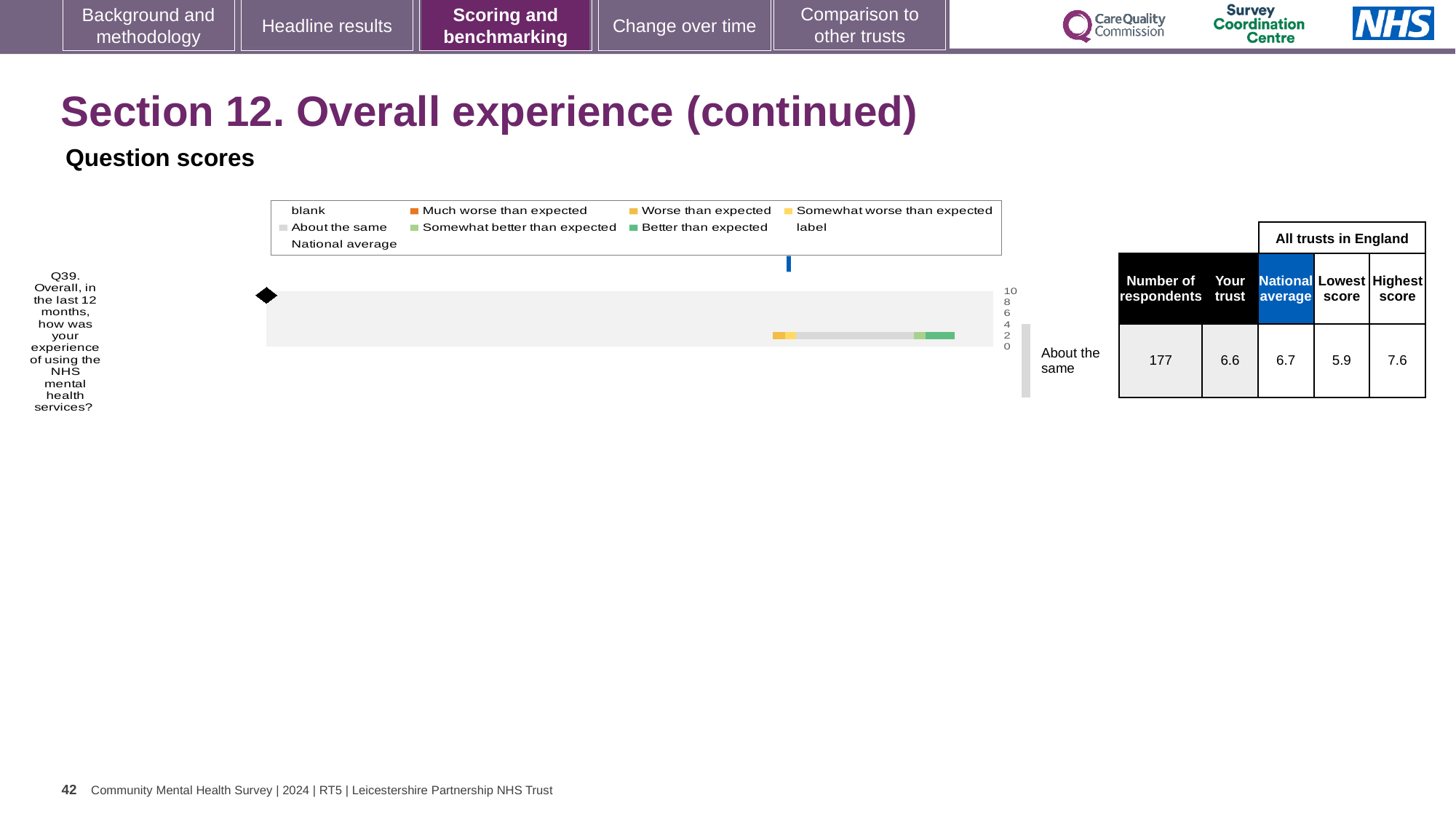
What is the lowest score among all trusts in England for Q39? 5.9 What is the highest score among all trusts in England for Q39? 7.6 What is the 'Your trust' score for Q39? 6.6 How many survey questions are plotted on the chart? 1 What is the difference between the national average and the 'Your trust' score for Q39? 0.1 Which is larger for Q39, the 'Your trust' score or the national average? National average Which question number is plotted on the chart? Q39 What is the difference between the highest and lowest trust scores for Q39? 1.7 What benchmark category is shown next to the Q39 bar? About the same What kind of chart is used to show the Q39 question score? bar chart What is the national average score for Q39? 6.7 How many respondents answered Q39? 177